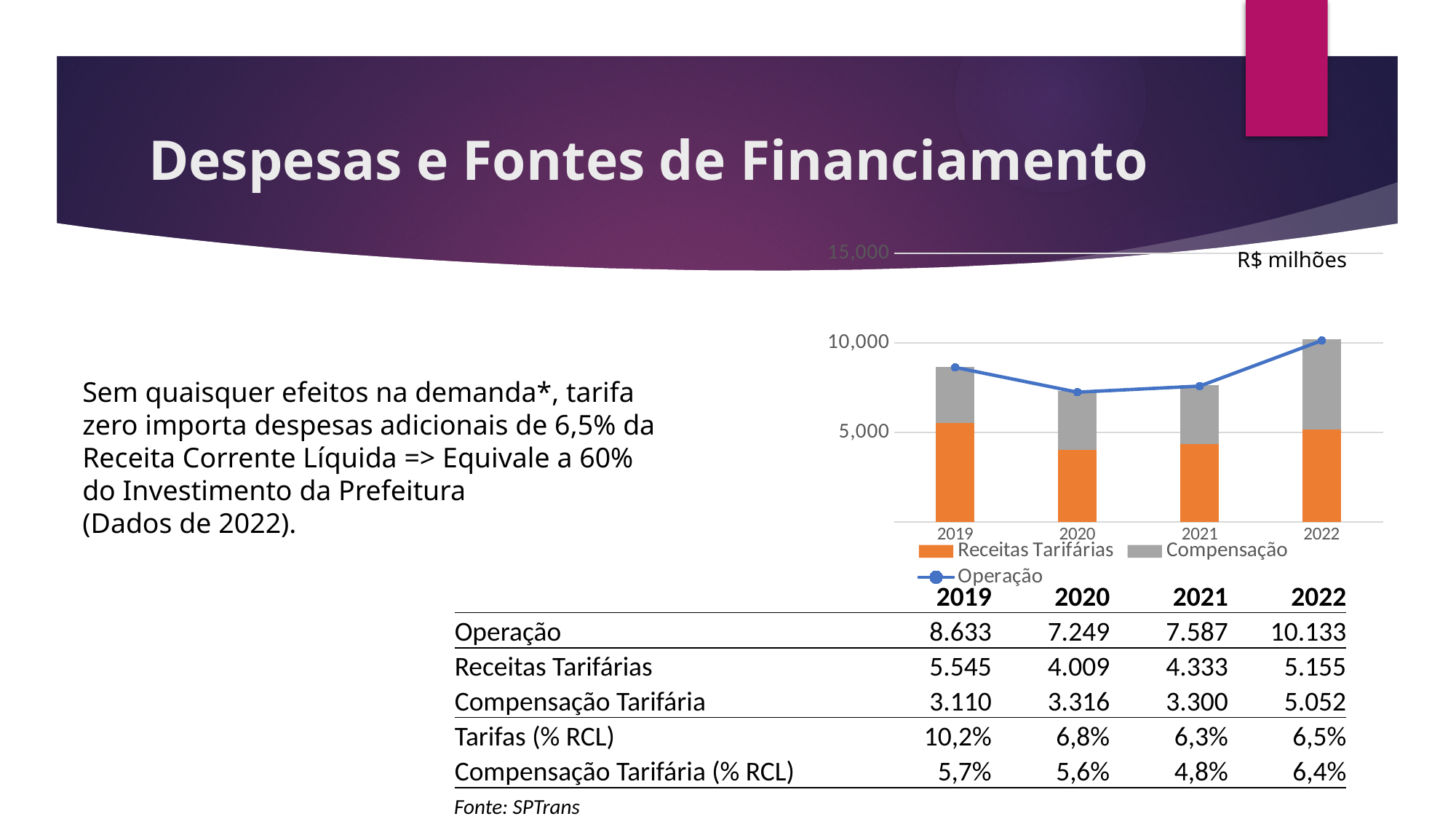
What unit is indicated at the top right of the chart? R$ milhões Does the Operação line rise or fall from 2020 to 2022? rise In which year is the Operação line at its lowest? 2020 In which year is the Operação line at its highest? 2022 According to the table below the chart, what is the value of Operação in 2022? 10.133 How many years are shown on the x axis of the chart? 4 Which is larger, Receitas Tarifárias in 2019 or in 2020? 2019 What kind of chart is shown on the slide? A stacked bar chart with a line How many series does the chart legend list? 3 Is the value for Operação in 2020 greater or less than 10,000? less Is the value for Receitas Tarifárias in 2020 greater or less than 5,000? less Using the table values, what is the total of the stacked bar for 2022 (Receitas Tarifárias plus Compensação Tarifária)? 10.207